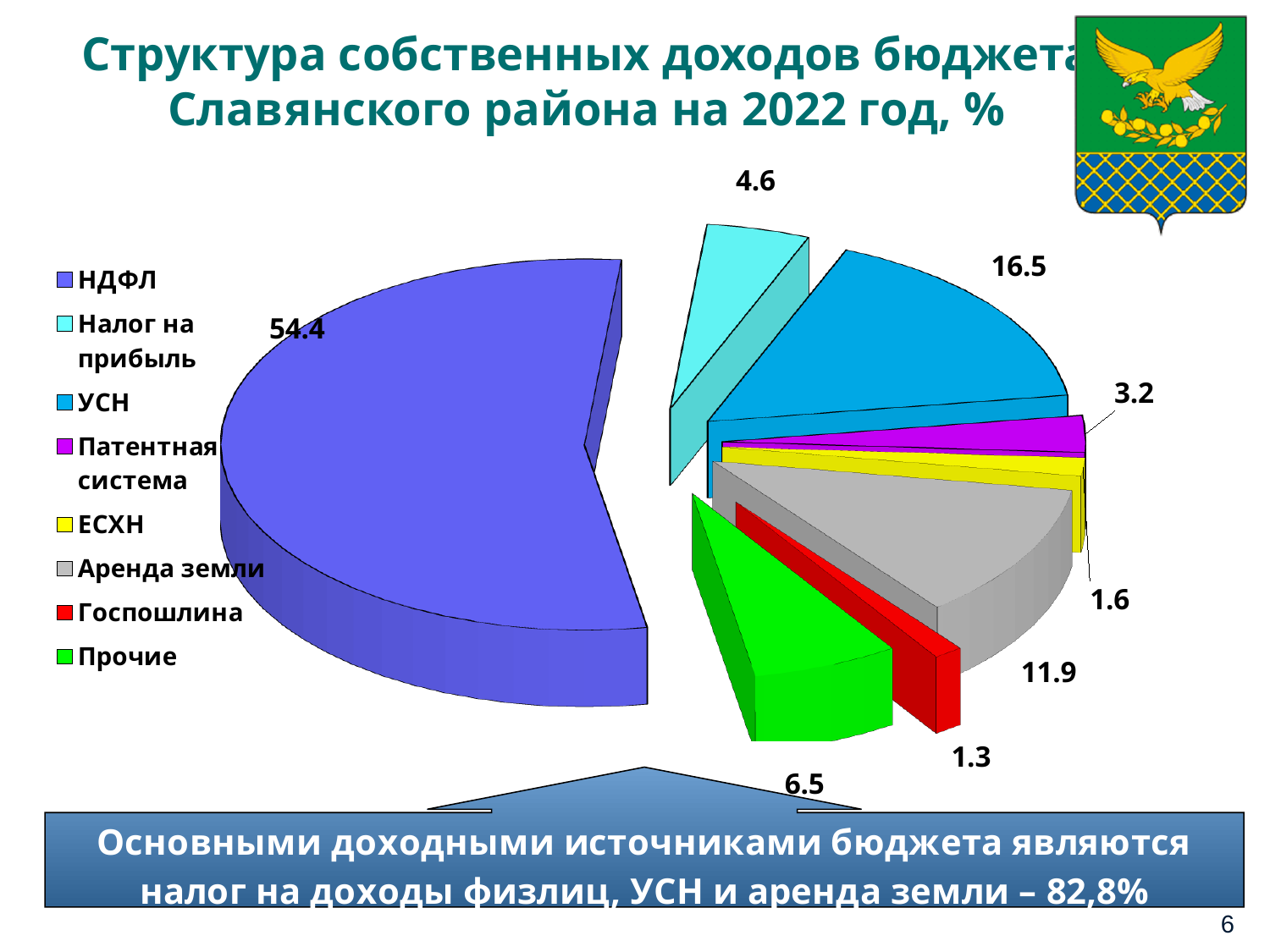
How many categories does the legend list? 8 Which category has the smallest share of the pie? Госпошлина What is the value for Аренда земли? 11.9 What is the value for Патентная система? 3.2 Which is larger, the value for Прочие or the value for Налог на прибыль? Прочие What is the value for УСН? 16.5 What kind of chart is shown on the slide? pie chart What is the value for НДФЛ? 54.4 What is the title of the chart? Структура собственных доходов бюджета Славянского района на 2022 год, % What is the value for Налог на прибыль? 4.6 Which category has the largest share of the pie? НДФЛ What is the difference between the values for УСН and Аренда земли? 4.6